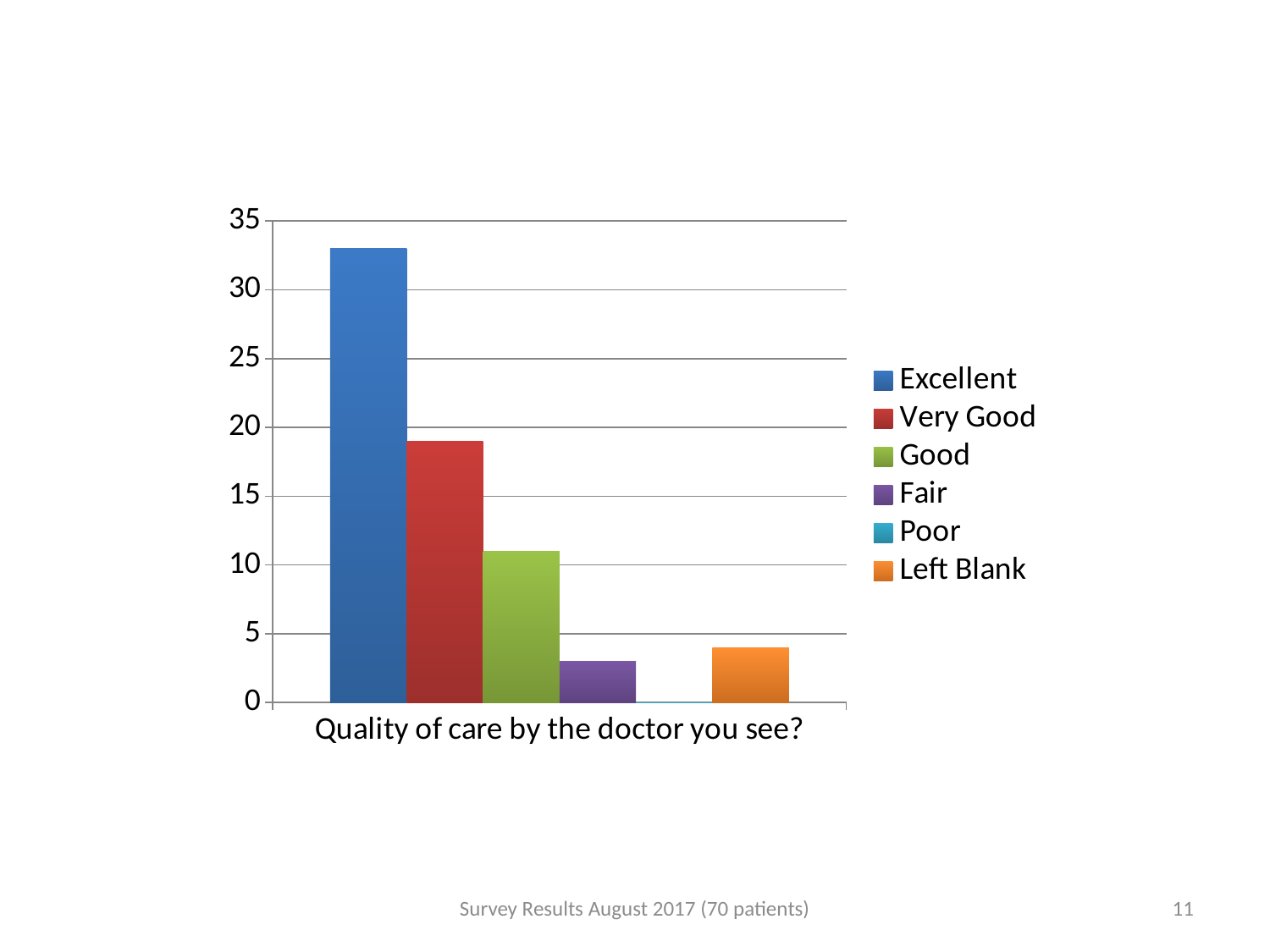
What is the label shown beneath the bars on the x axis? Quality of care by the doctor you see? Which category has the lowest value in the chart? Poor Is the value for Left Blank greater or less than 5? less Is the value for Fair greater or less than 5? less How many series does the legend list? 6 Which is larger, the value for Very Good or the value for Good? Very Good Is the value for Excellent greater or less than 30? greater What kind of chart is shown on the slide? bar chart Which category has the highest value in the chart? Excellent Which is larger, the value for Left Blank or the value for Fair? Left Blank